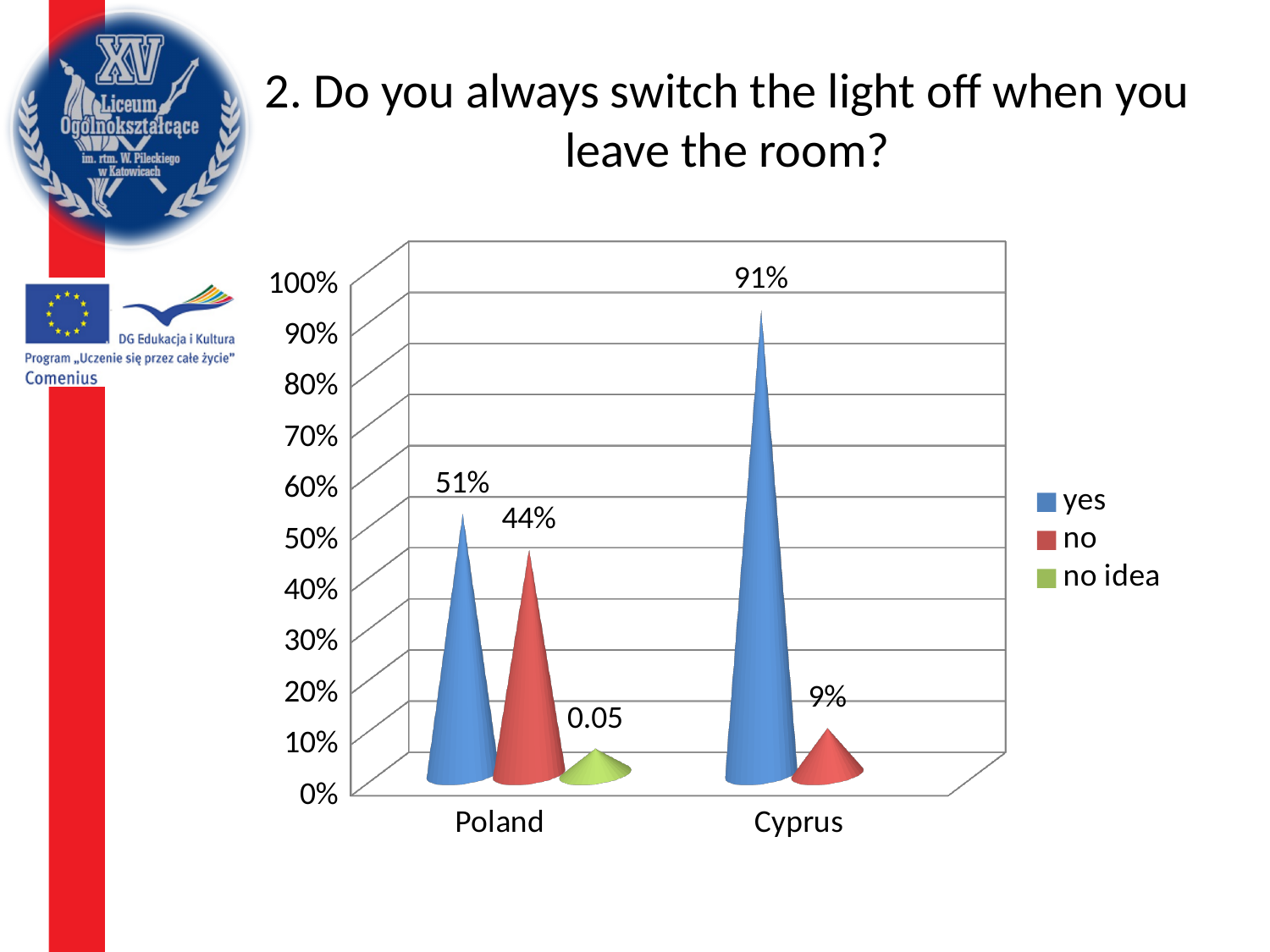
Which country has the higher "yes" value? Cyprus What percentage of respondents in Poland answered "yes"? 51% What is the difference between the "yes" and "no" values for Poland? 7% How many countries are shown on the x axis? 2 What percentage of respondents in Poland answered "no"? 44% Which country has the lower "no" value? Cyprus What is the data label shown for "no idea" in Poland? 0.05 What kind of chart is shown on the slide? Bar chart What percentage of respondents in Cyprus answered "yes"? 91% How many series does the legend list? 3 Which colour represents the "no idea" series in the legend? Green What is the difference between the "yes" values for Cyprus and Poland? 40%